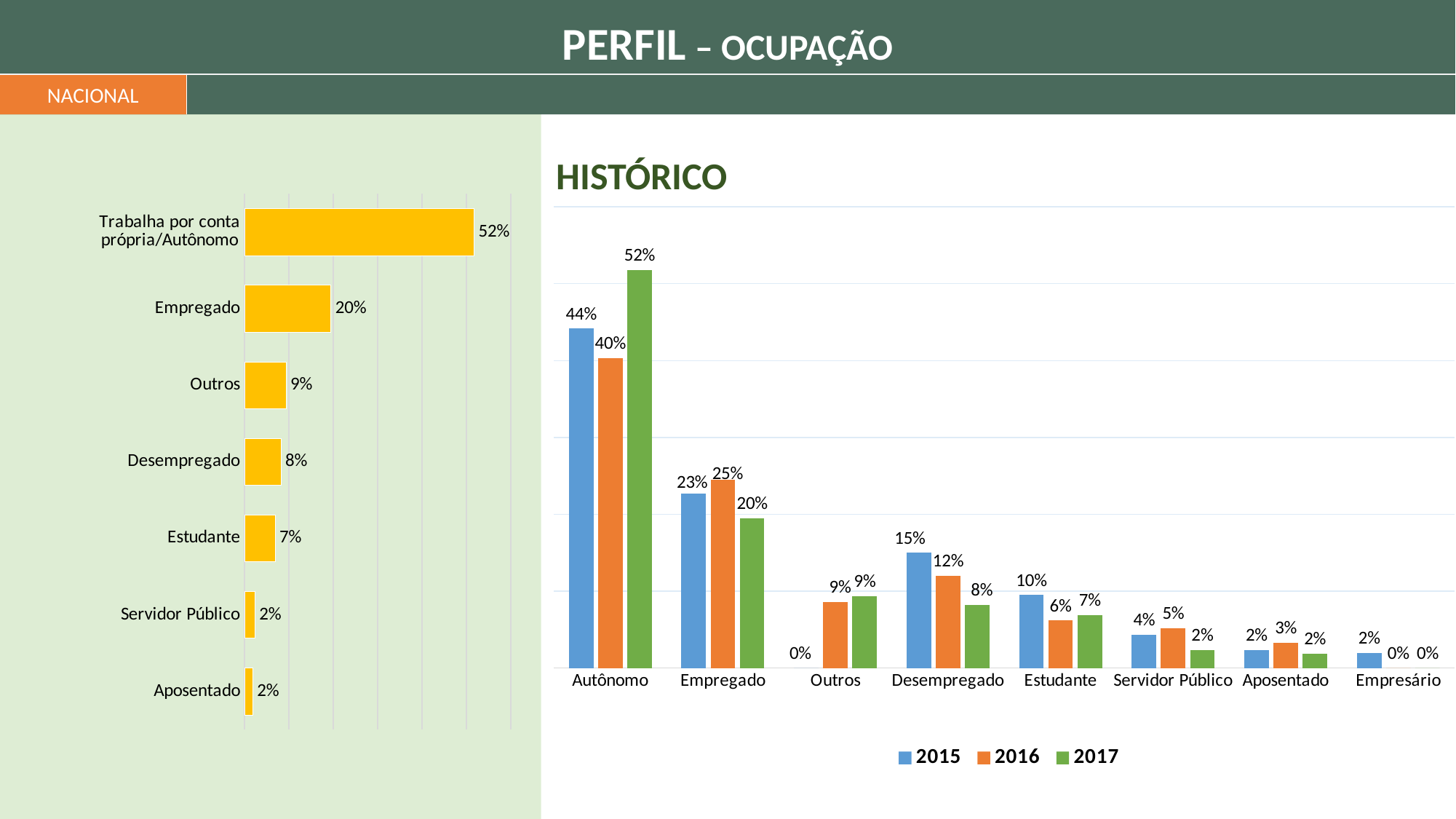
In the HISTÓRICO chart, how many series does the legend list? 3 In the HISTÓRICO chart, do the values for Empregado rise or fall from 2016 to 2017? fall In the HISTÓRICO chart, how many categories are shown on the x axis? 8 In the HISTÓRICO chart, what is the value for Desempregado in 2015? 15% In the left-hand bar chart, which category has the highest value? Trabalha por conta própria/Autônomo In the left-hand bar chart, how many categories are shown? 7 In the HISTÓRICO chart, what is the value for Autônomo in 2016? 40% What kind of chart is the HISTÓRICO chart? bar chart In the HISTÓRICO chart, which is larger for Estudante: the 2015 value or the 2017 value? 2015 In the HISTÓRICO chart, what is the difference between the 2017 and 2015 values for Autônomo? 8% In the left-hand bar chart, what is the value for Empregado? 20% In the left-hand bar chart, what is the difference between the values for Outros and Desempregado? 1%